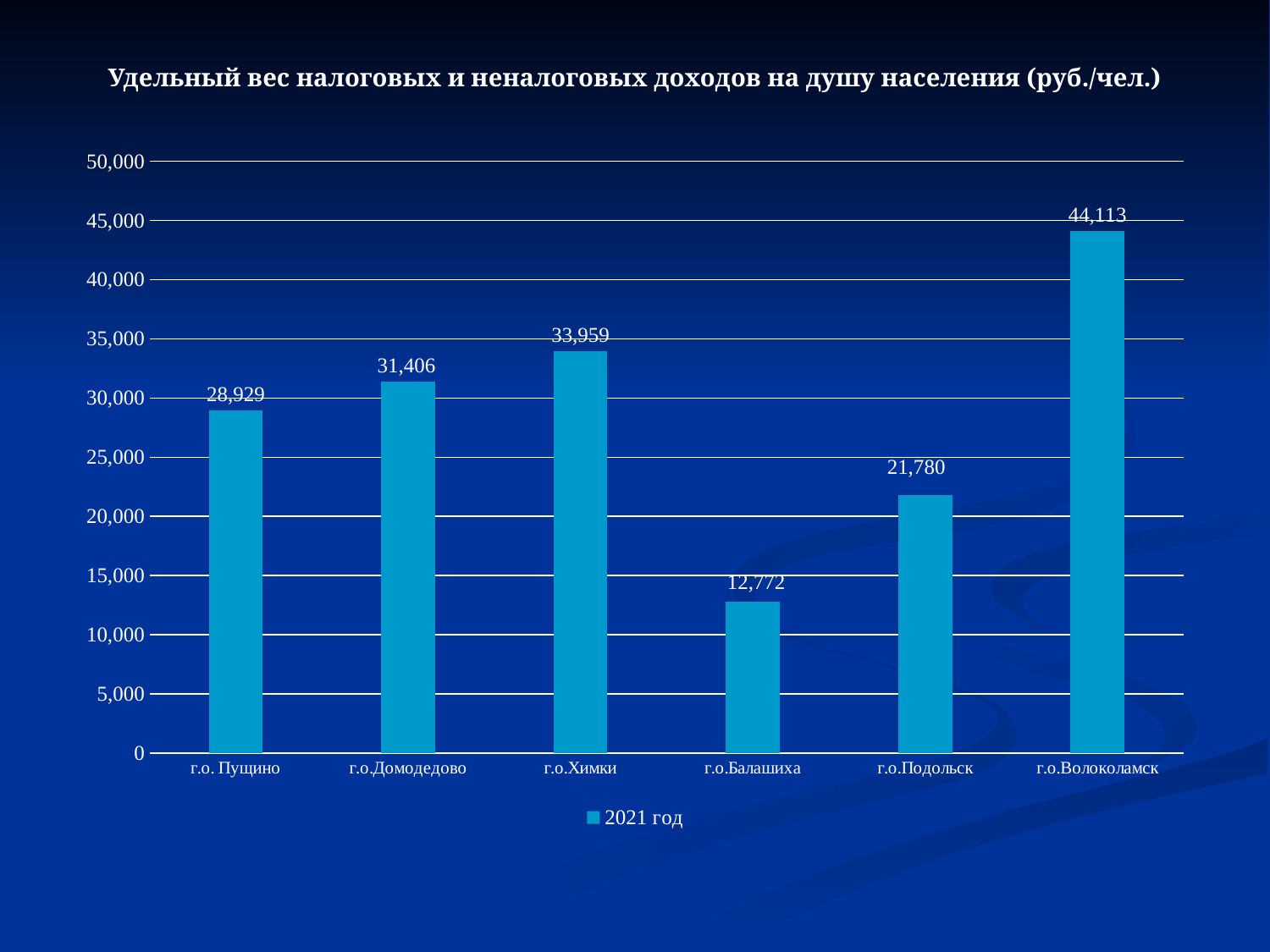
What series does the legend list? 2021 год How many categories are shown on the x axis? 6 Which is larger, the value for г.о.Химки or the value for г.о.Домодедово? г.о.Химки What is the value for г.о.Подольск? 21,780 Which category has the lowest value? г.о.Балашиха Is the value for г.о.Подольск greater or less than 25,000? less What is the difference between the values for г.о.Волоколамск and г.о.Химки? 10,154 What is the value for г.о. Пущино? 28,929 Which category has the highest value? г.о.Волоколамск What is the difference between the values for г.о.Домодедово and г.о. Пущино? 2,477 What is the value for г.о.Балашиха? 12,772 What kind of chart is shown on the slide? bar chart